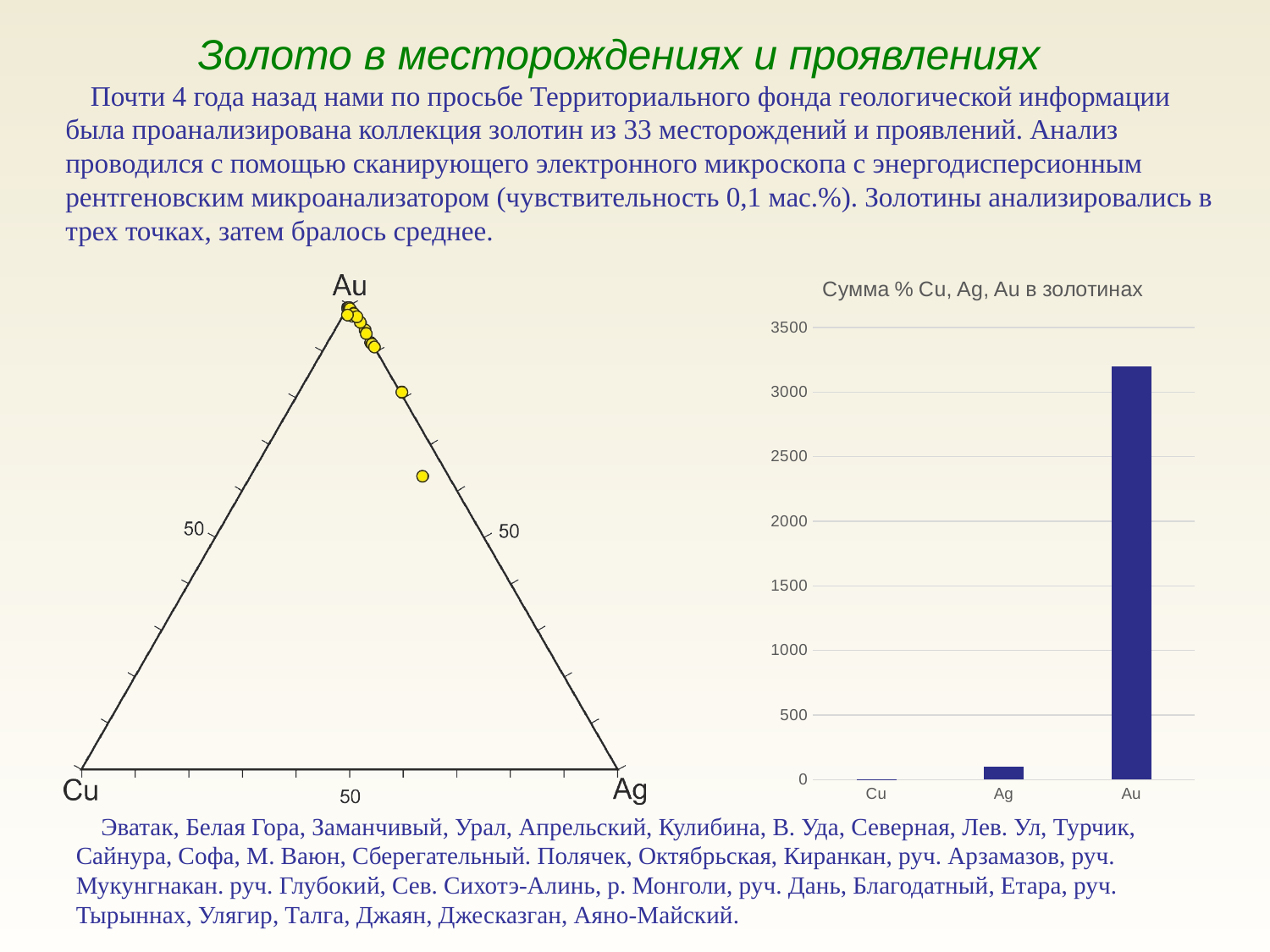
What kind of chart is the chart titled "Сумма % Cu, Ag, Au в золотинах"? bar chart In the chart titled "Сумма % Cu, Ag, Au в золотинах", which is larger, the value for Ag or the value for Au? Au In the chart titled "Сумма % Cu, Ag, Au в золотинах", which category has the lowest value? Cu In the chart titled "Сумма % Cu, Ag, Au в золотинах", is the value for Au greater or less than 3000? greater In the chart titled "Сумма % Cu, Ag, Au в золотинах", which is larger, the value for Cu or the value for Ag? Ag In the chart titled "Сумма % Cu, Ag, Au в золотинах", which category has the highest value? Au In the chart titled "Сумма % Cu, Ag, Au в золотинах", is the value for Ag greater or less than 500? less In the chart titled "Сумма % Cu, Ag, Au в золотинах", is the value for Au greater or less than 3500? less What is the highest tick value shown on the vertical axis of the chart titled "Сумма % Cu, Ag, Au в золотинах"? 3500 What are the three vertex labels of the triangular diagram on the left of the slide? Au, Cu, Ag How many categories are shown on the x axis of the chart titled "Сумма % Cu, Ag, Au в золотинах"? 3 In the chart titled "Сумма % Cu, Ag, Au в золотинах", do the values rise or fall from Cu to Au along the x axis? rise